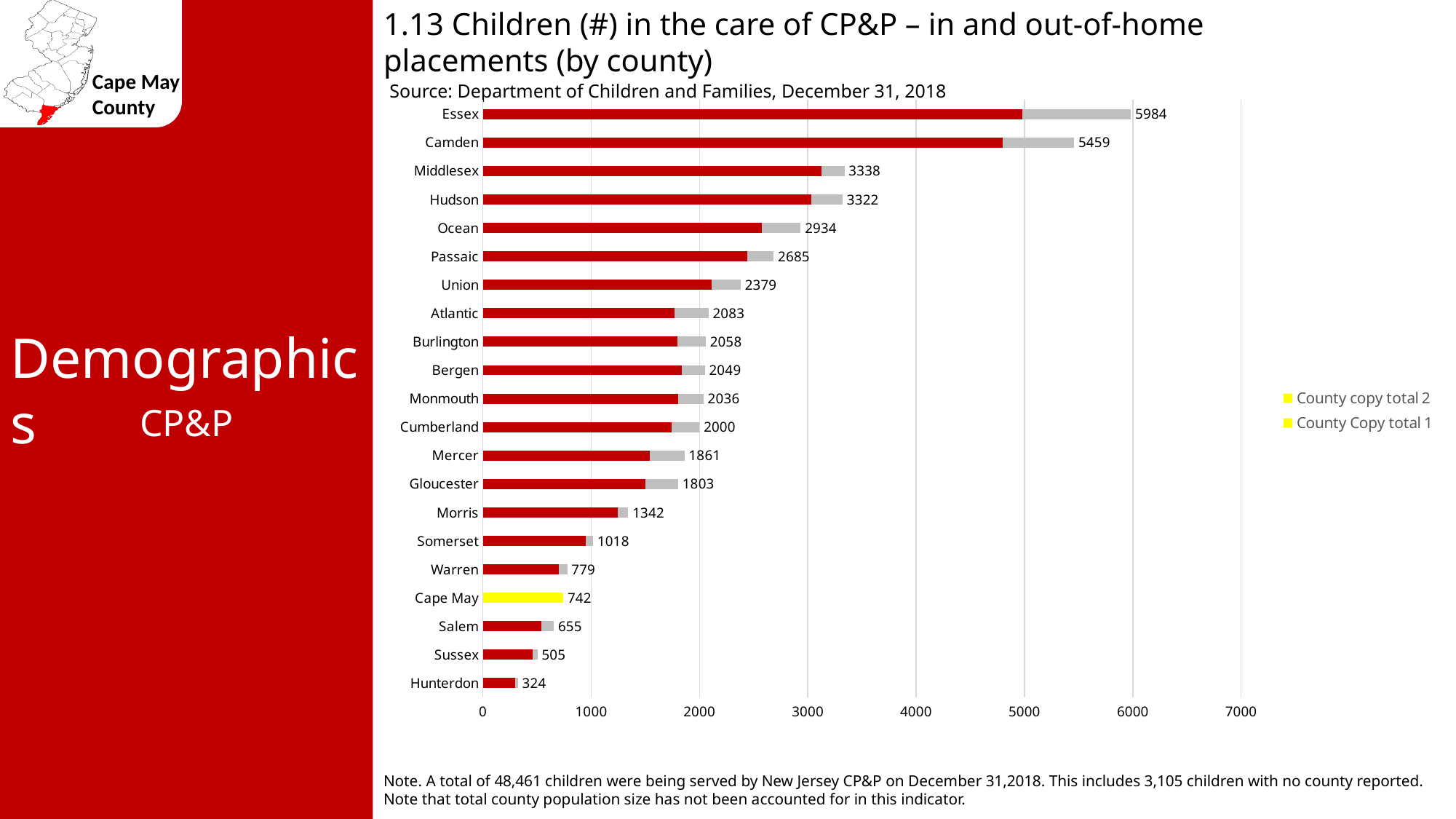
Is the total for Cape May greater or less than 1000? less Which county has a larger total, Middlesex or Ocean? Middlesex How many counties are shown in the chart? 21 What is the total number of children in the care of CP&P for Hunterdon county? 324 What kind of chart is shown on the slide? Bar chart What is the total number of children in the care of CP&P for Essex county? 5984 How many series does the legend list? 2 What is the difference between the totals for Essex and Camden? 525 Which county has the highest total number of children in the care of CP&P? Essex Which county has the lowest total number of children in the care of CP&P? Hunterdon What is the total number of children in the care of CP&P for Cape May county? 742 What is the difference between the totals for Cape May and Salem? 87